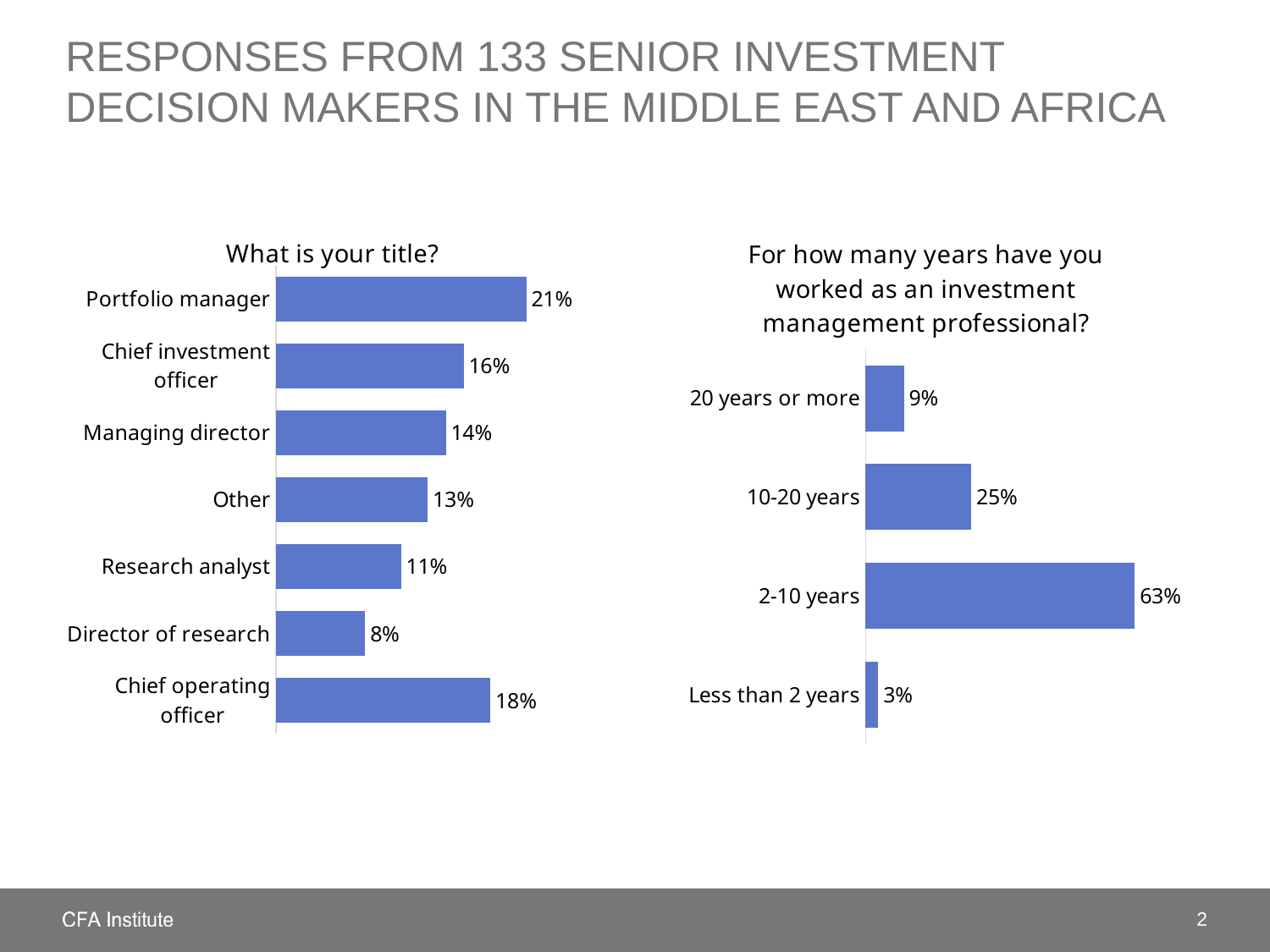
In the 'What is your title?' chart, how many title categories are shown? 7 In the chart on the right about years worked as an investment management professional, how many categories are shown? 4 In the 'What is your title?' chart, what is the value for Chief operating officer? 18% In the chart on the right about years worked as an investment management professional, which category has the lowest percentage? Less than 2 years In the 'What is your title?' chart, which title has the lowest percentage? Director of research In the chart on the right about years worked as an investment management professional, what is the value for 2-10 years? 63% What type of chart is the 'What is your title?' chart? Bar chart In the 'What is your title?' chart, what percentage of respondents are portfolio managers? 21% In the 'What is your title?' chart, which is larger: Chief investment officer or Research analyst? Chief investment officer In the 'What is your title?' chart, what is the difference between Portfolio manager and Managing director? 7% In the 'What is your title?' chart, which title has the highest percentage? Portfolio manager In the chart on the right about years worked as an investment management professional, what is the difference between 10-20 years and 20 years or more? 16%